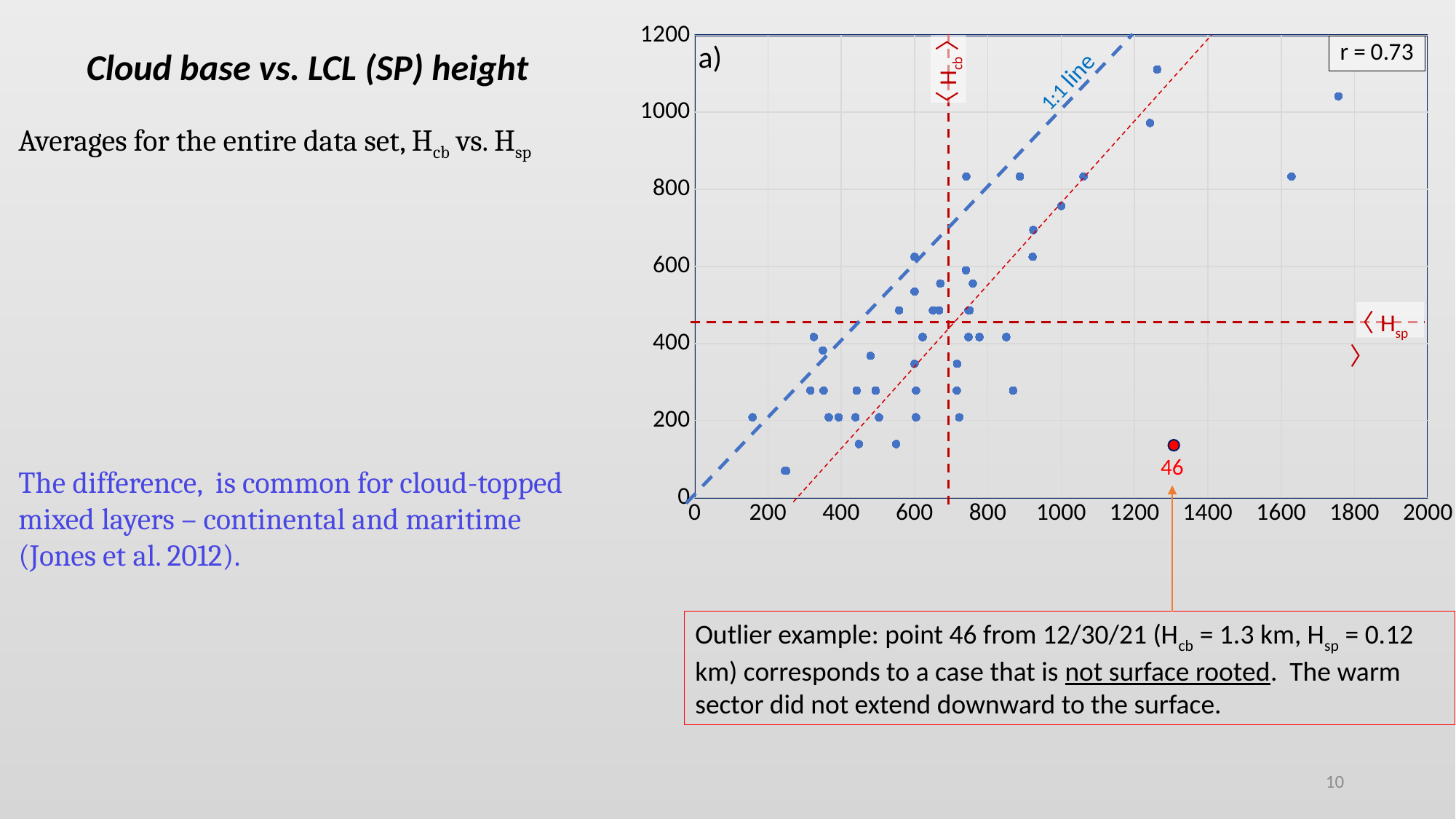
What is the maximum value shown on the x axis of the chart? 2000 What correlation coefficient r is printed on the chart? r = 0.73 Is the y-axis value of the rightmost point in the chart greater or less than 800? greater According to the slide text, what is the Hsp value of outlier point 46? 0.12 km What kind of chart is shown on the slide? scatter plot According to the slide text, what is the Hcb value of outlier point 46? 1.3 km Is the x-axis value of point 46 greater or less than 1200? greater Do the plotted points generally rise or fall as the x-axis value increases? rise What is the label on the dashed blue line in the chart? 1:1 line Which point number is highlighted in red as the outlier example? 46 What panel letter is printed in the top-left corner of the chart? a) Is the y-axis value of point 46 greater or less than 200? less